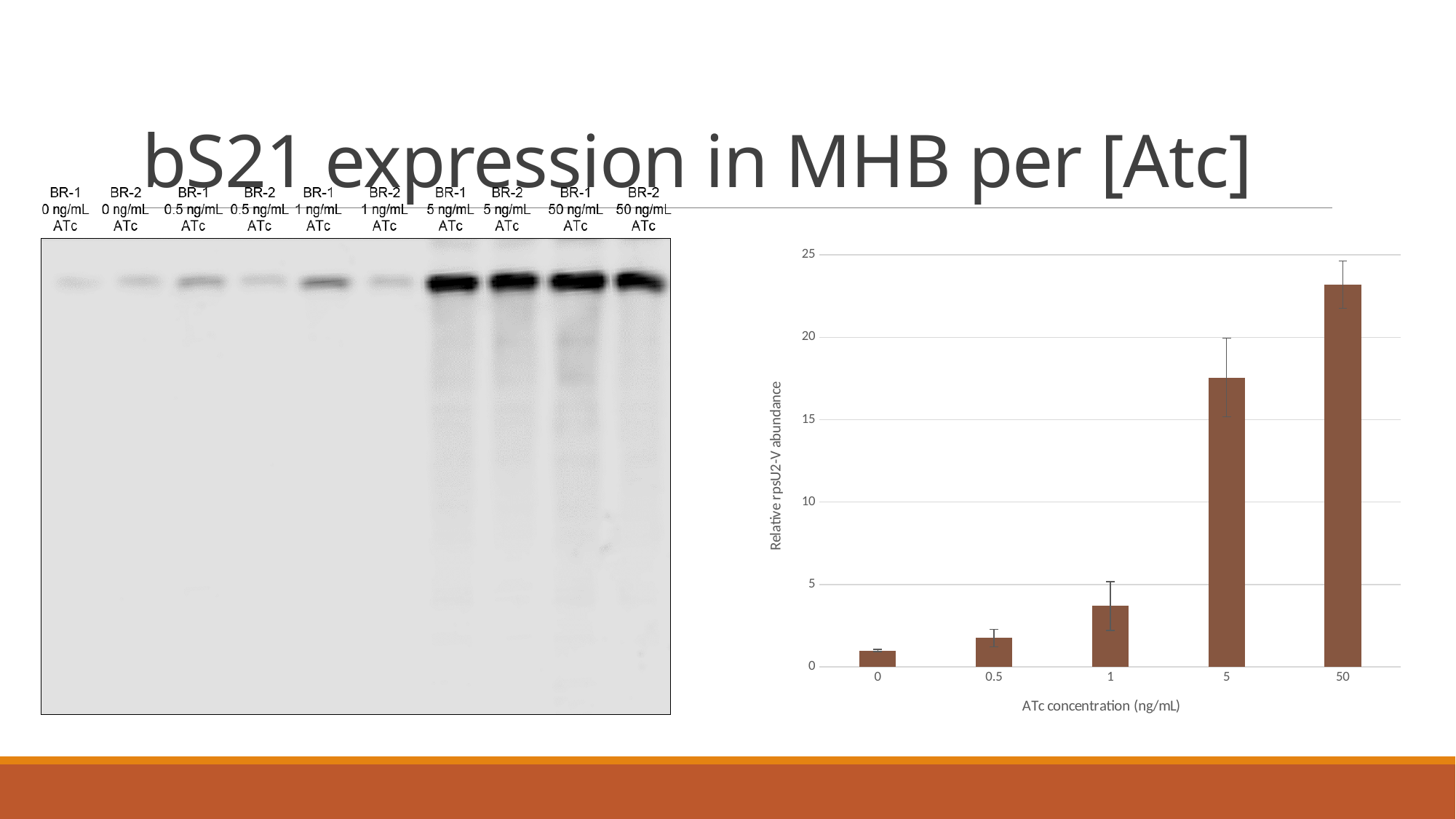
Is the relative rpsU2-V abundance at 5 ng/mL ATc greater or less than 15? greater Which ATc concentration has the highest relative rpsU2-V abundance? 50 Do the bar values rise or fall as ATc concentration increases along the x axis? rise Which ATc concentration has the lowest relative rpsU2-V abundance? 0 Which has a larger relative rpsU2-V abundance, 5 ng/mL ATc or 1 ng/mL ATc? 5 ng/mL ATc Is the relative rpsU2-V abundance at 50 ng/mL ATc greater or less than 20? greater Is the relative rpsU2-V abundance at 0.5 ng/mL ATc greater or less than 5? less How many ATc concentration categories are plotted on the x axis of the bar chart? 5 What kind of chart is shown on the slide? bar chart What is the label of the x axis of the bar chart? ATc concentration (ng/mL) What is the label of the y axis of the bar chart? Relative rpsU2-V abundance